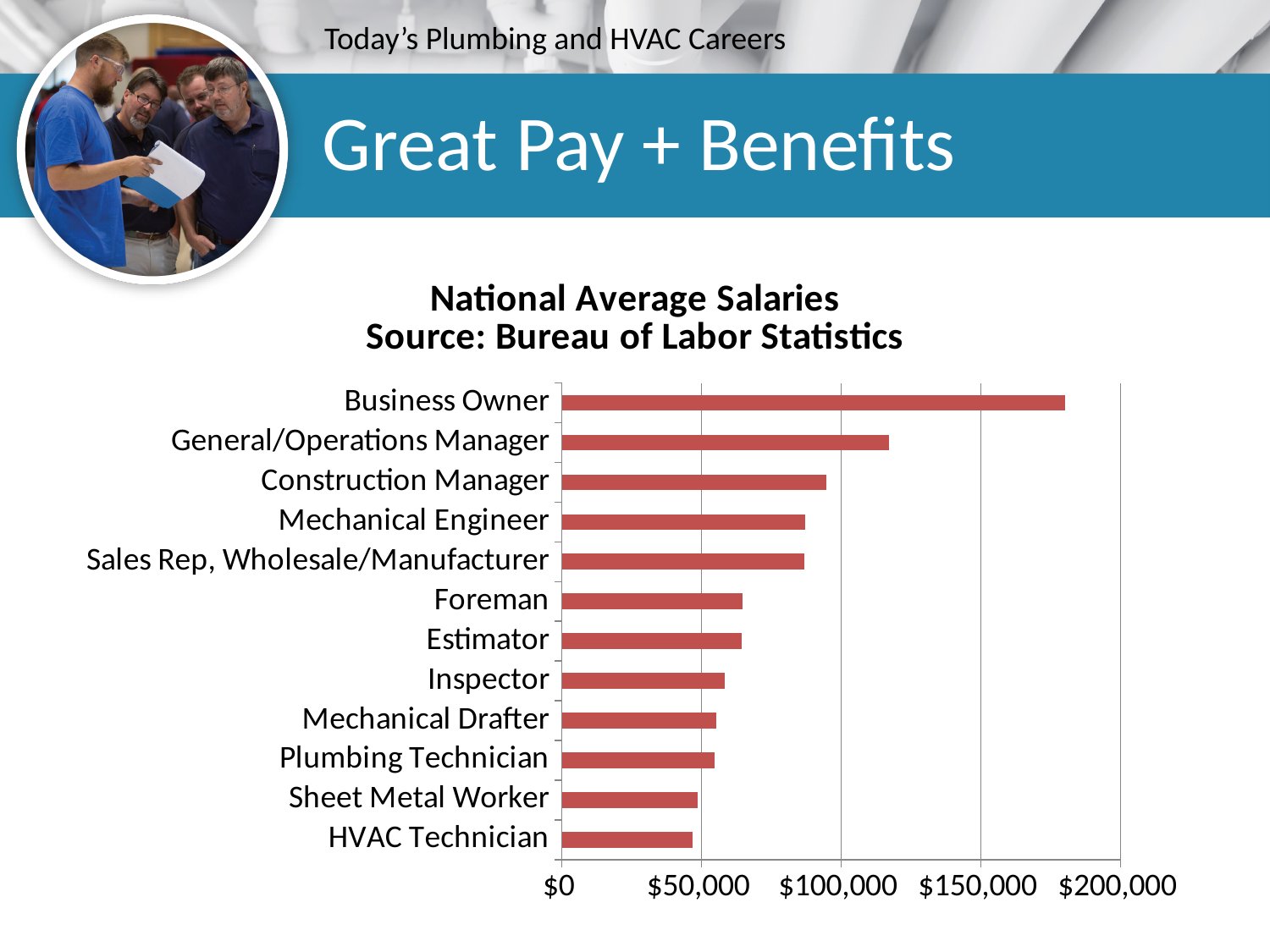
Is the value for Business Owner greater or less than $150,000? greater Is the value for General/Operations Manager greater or less than $100,000? greater Is the value for Construction Manager greater or less than $100,000? less What kind of chart is shown on the slide? bar chart How many job categories are plotted in the chart? 12 Which has a higher average salary, Construction Manager or Foreman? Construction Manager Which job category has the lowest national average salary in the chart? HVAC Technician Which has a higher average salary, Inspector or Sheet Metal Worker? Inspector Which job category has the highest national average salary in the chart? Business Owner What source is cited in the chart title for the salary data? Bureau of Labor Statistics